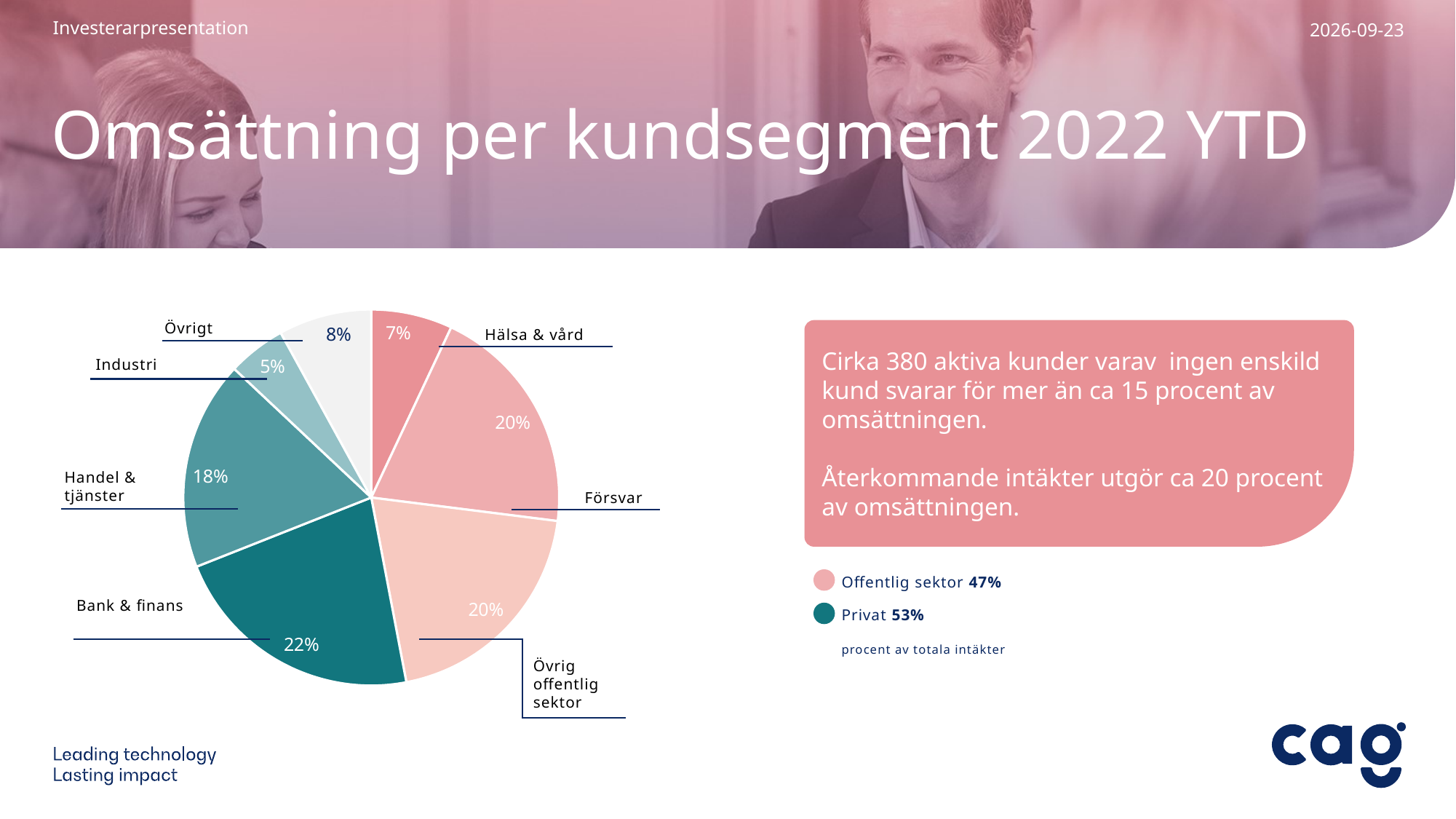
What share does Handel & tjänster have in the pie chart? 18% Which customer segment has the smallest share of revenue? Industri How many customer segments are shown in the pie chart? 7 What is the difference in percentage points between Bank & finans and Handel & tjänster? 4 What is the combined share of Försvar and Övrig offentlig sektor? 40% Which customer segment has the largest share of revenue? Bank & finans What percentage is shown for Industri? 5% According to the legend, what share of total revenue comes from Privat? 53% What type of chart is shown on the slide? Pie chart Which is larger, the share for Övrigt or the share for Hälsa & vård? Övrigt What percentage of revenue does Bank & finans account for? 22% What is the value shown for Hälsa & vård? 7%